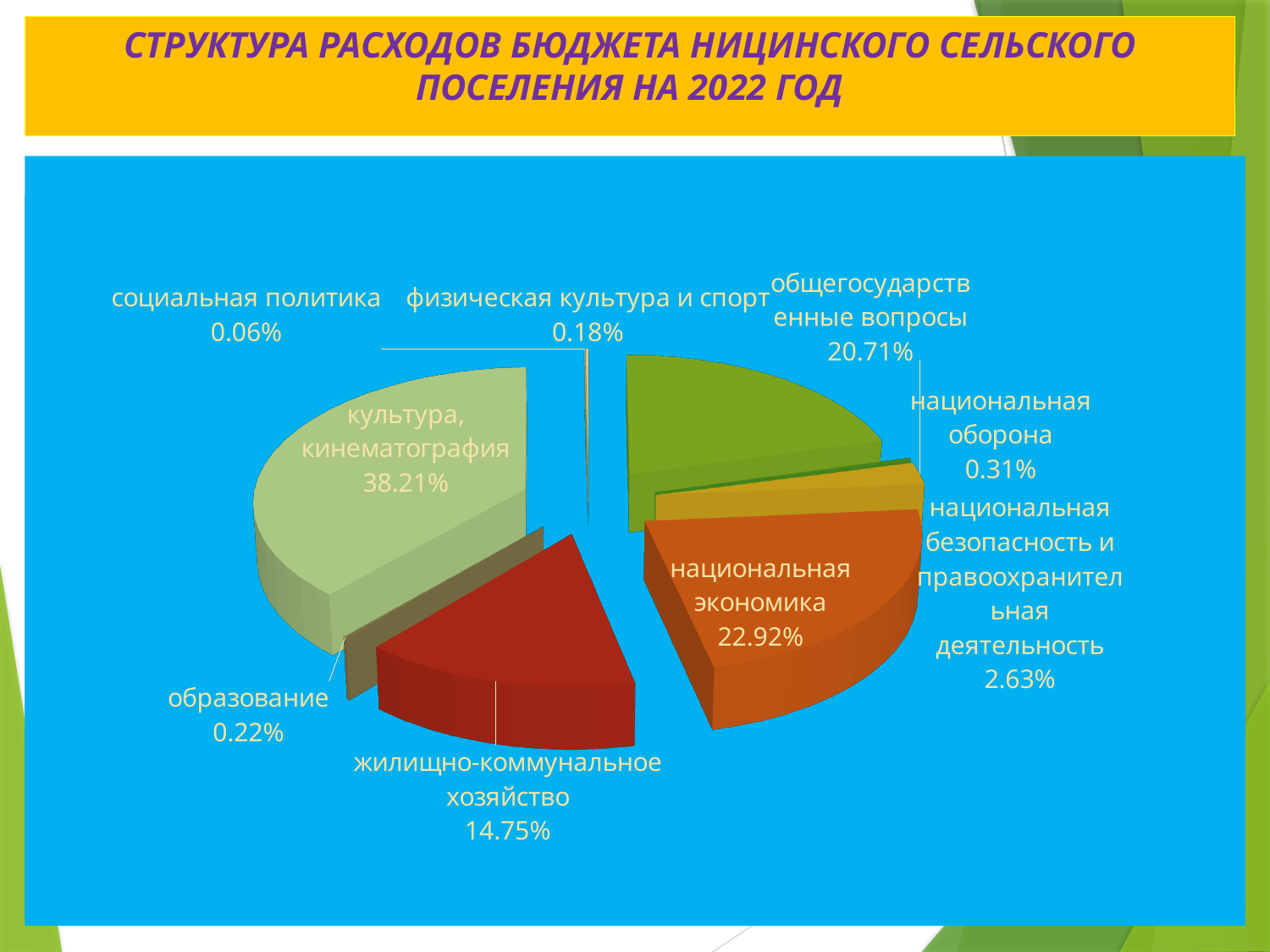
What is the value shown for общегосударственные вопросы? 20.71% Which is larger: the share for жилищно-коммунальное хозяйство or the share for общегосударственные вопросы? общегосударственные вопросы What share of the budget expenditure goes to культура, кинематография? 38.21% Which category has the largest share of the pie? культура, кинематография Which category has the smallest share of the pie? социальная политика What is the value shown for национальная безопасность и правоохранительная деятельность? 2.63% What kind of chart is shown on the slide? pie chart What is the difference between the shares of национальная экономика and общегосударственные вопросы? 2.21% What is the title of the slide containing the chart? СТРУКТУРА РАСХОДОВ БЮДЖЕТА НИЦИНСКОГО СЕЛЬСКОГО ПОСЕЛЕНИЯ НА 2022 ГОД What is the value shown for национальная экономика? 22.92% How many categories are shown in the pie chart? 9 What is the value shown for жилищно-коммунальное хозяйство? 14.75%